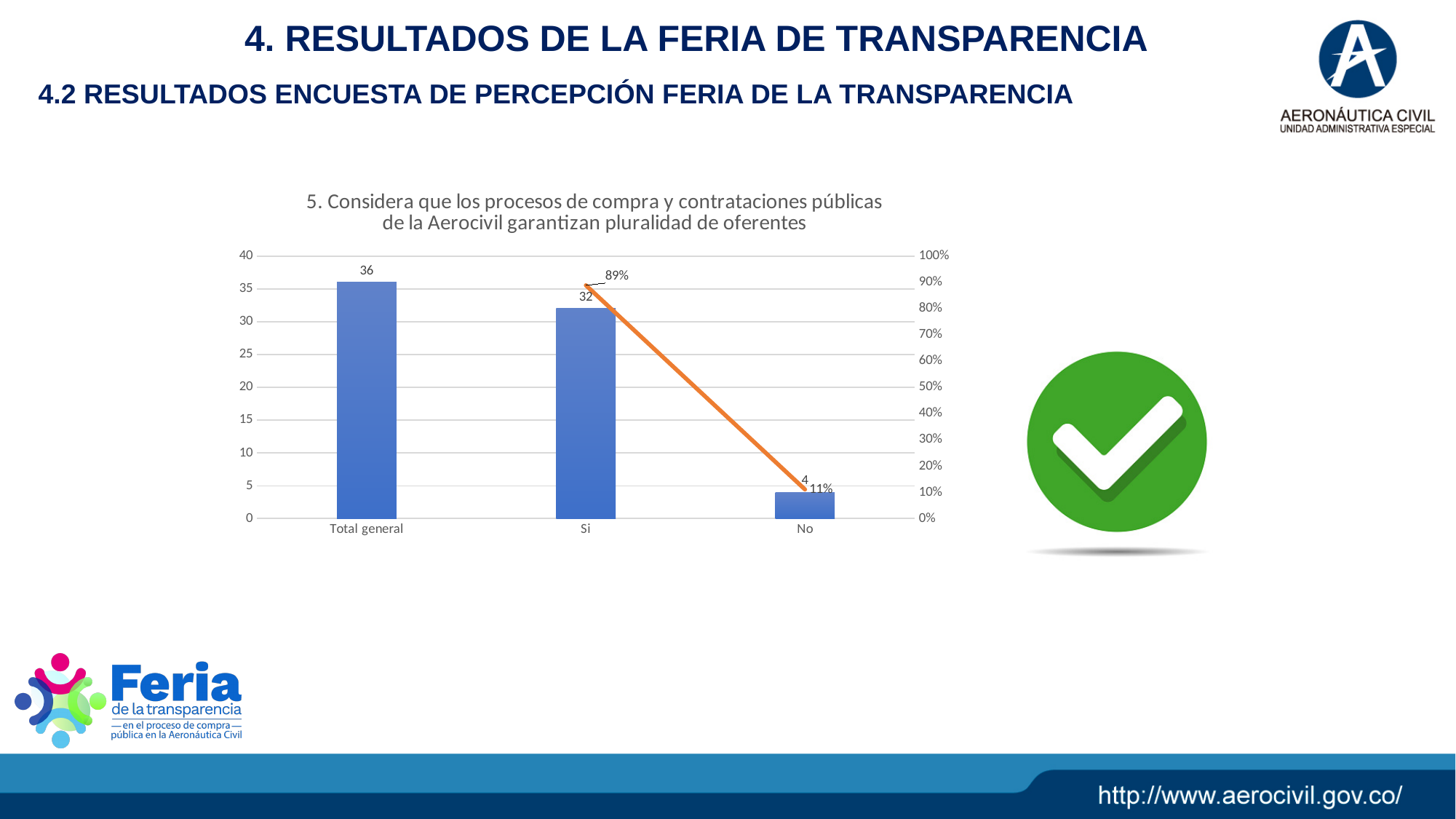
Does the percentage line rise or fall from 'Si' to 'No'? fall What percentage is shown on the line for 'Si'? 89% Which is larger, the bar for 'Si' or the bar for 'No'? Si What is the value of the bar for 'Si'? 32 What is the title of the chart? 5. Considera que los procesos de compra y contrataciones públicas de la Aerocivil garantizan pluralidad de oferentes Which category has the highest bar? Total general What percentage is shown on the line for 'No'? 11% What is the difference between the bar values for 'Si' and 'No'? 28 What is the value of the bar for 'No'? 4 How many categories are shown on the x axis? 3 Which category has the lowest bar? No What is the value of the bar for 'Total general'? 36